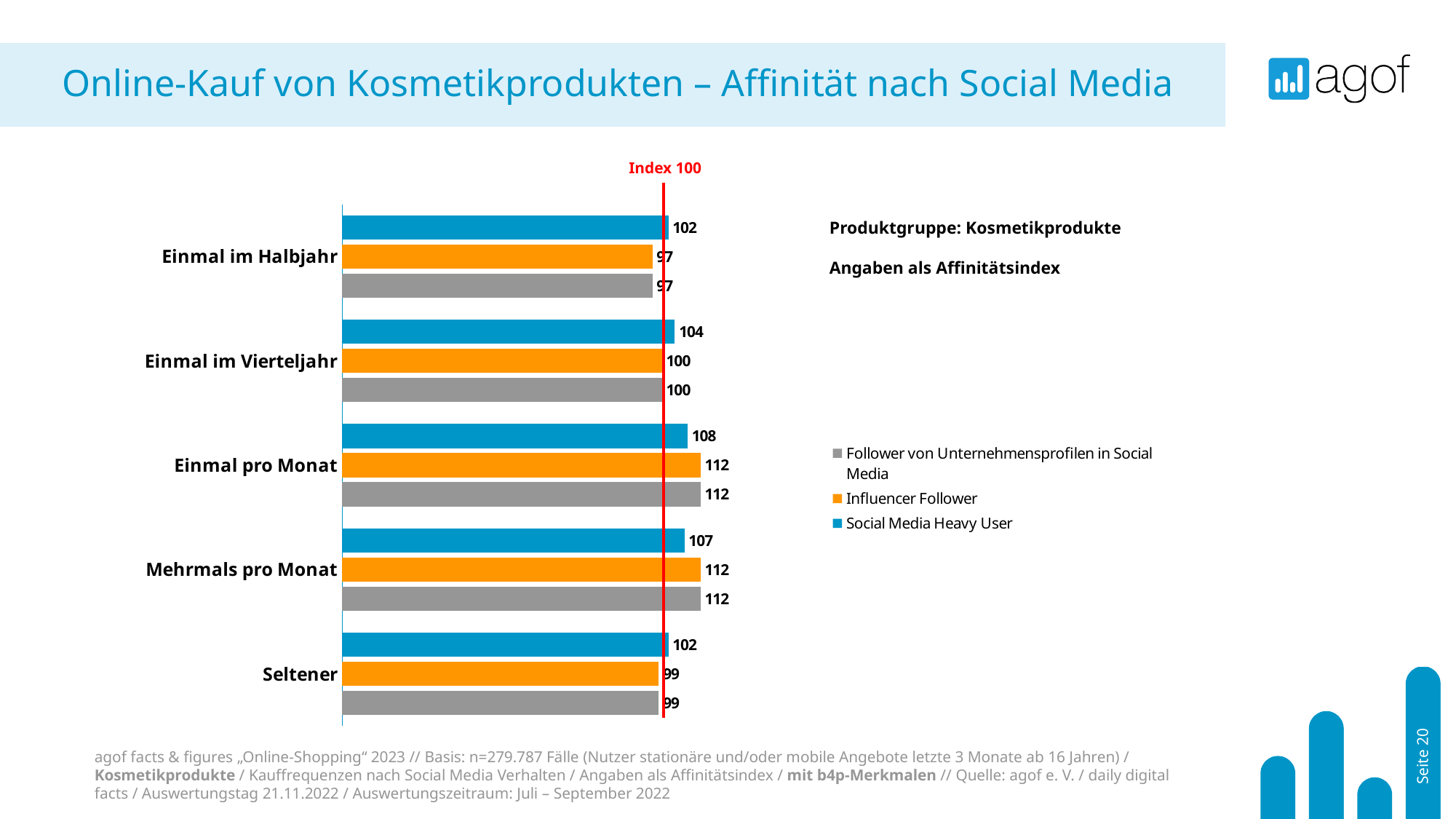
What kind of chart is shown on the slide? Bar chart Which category has the lowest value for Influencer Follower? Einmal im Halbjahr What is the difference between the Influencer Follower value and the Social Media Heavy User value in the Einmal pro Monat category? 4 Which category has the highest value for Social Media Heavy User? Einmal pro Monat How many series does the legend list? 3 What is the value for Social Media Heavy User in the Einmal pro Monat category? 108 What is the value for Social Media Heavy User in the Mehrmals pro Monat category? 107 What is the value for Follower von Unternehmensprofilen in Social Media in the Seltener category? 99 What value does the red vertical reference line on the chart mark? Index 100 In the Einmal im Vierteljahr category, which is larger: the Social Media Heavy User value or the Influencer Follower value? Social Media Heavy User What is the value for Influencer Follower in the Einmal im Halbjahr category? 97 How many categories are shown on the chart? 5